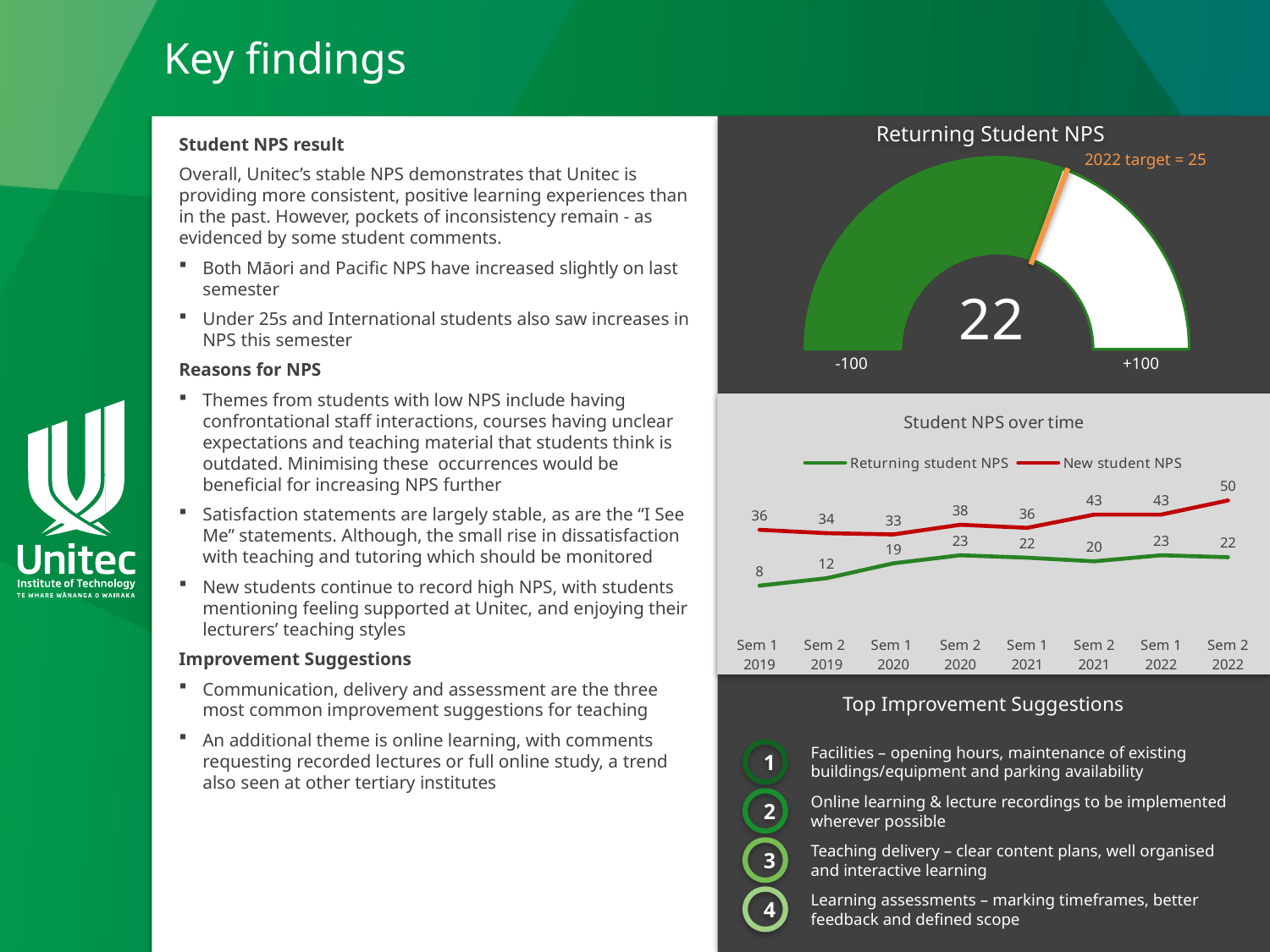
In the 'Student NPS over time' chart, which semester has the highest New student NPS? Sem 2 2022 In the 'Student NPS over time' chart, what is the difference between the New student NPS and the Returning student NPS in Sem 2 2022? 28 In the 'Student NPS over time' chart, what is the Returning student NPS for Sem 2 2020? 23 In the 'Student NPS over time' chart, what is the Returning student NPS for Sem 1 2019? 8 In the 'Student NPS over time' chart, which is larger in Sem 1 2021: the New student NPS or the Returning student NPS? New student NPS How many series does the legend of the 'Student NPS over time' chart list? 2 In the 'Student NPS over time' chart, what is the New student NPS for Sem 2 2022? 50 How many semesters are shown on the x axis of the 'Student NPS over time' chart? 8 In the 'Returning Student NPS' gauge chart, what value is shown and what is the 2022 target? 22; 2022 target = 25 In the 'Student NPS over time' chart, which semester has the lowest Returning student NPS? Sem 1 2019 What kind of chart is 'Student NPS over time'? Line chart In the 'Student NPS over time' chart, does the New student NPS rise or fall from Sem 1 2020 to Sem 2 2022? Rise